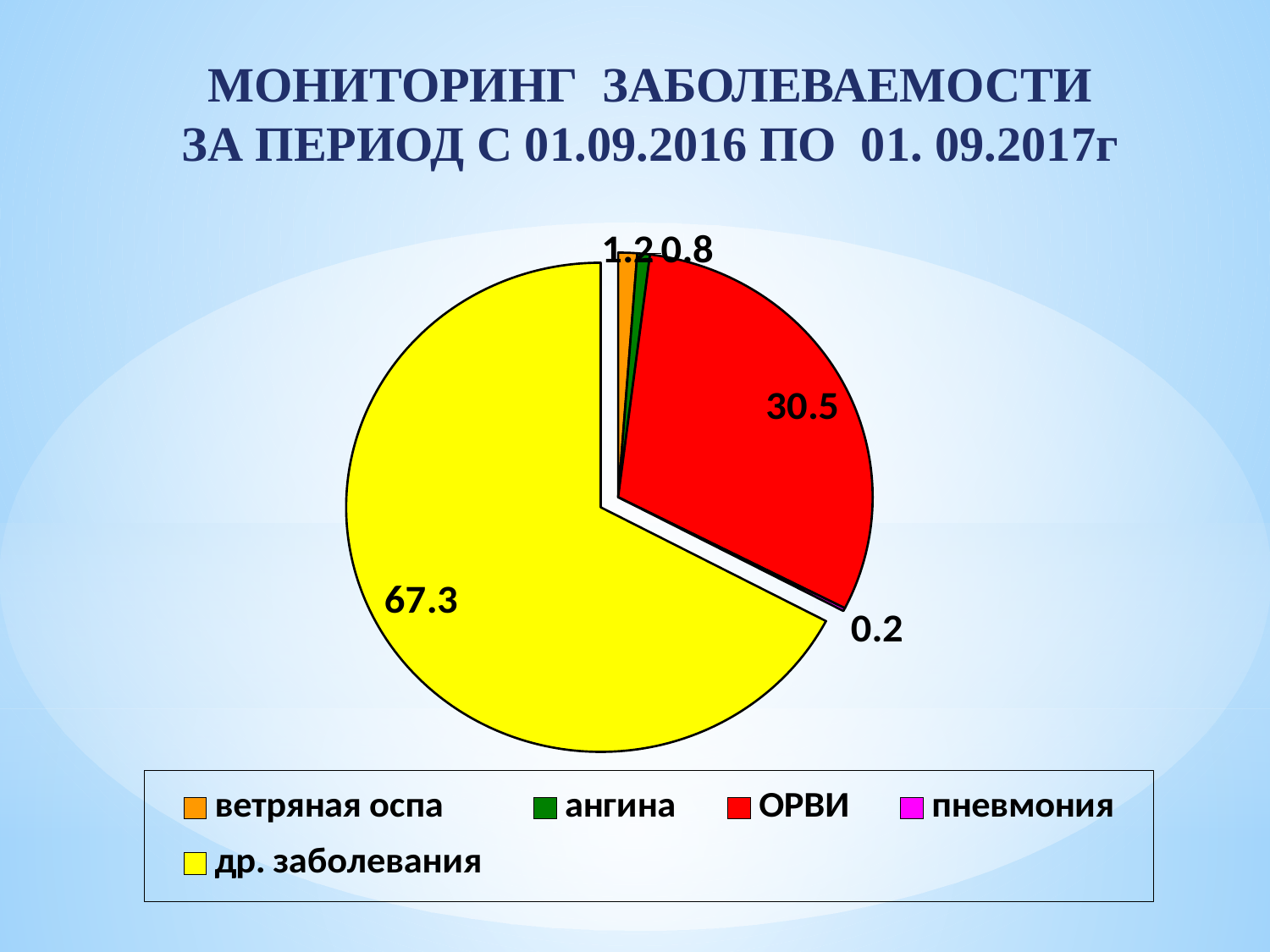
Which category is shown in yellow? др. заболевания Which category has the largest slice of the pie? др. заболевания Which category has the smallest slice of the pie? пневмония How many categories does the legend list? 5 What is the value for ангина? 0.8 What colour is the slice for ОРВИ? red What is the difference between the values for др. заболевания and ОРВИ? 36.8 What is the value for ОРВИ? 30.5 What kind of chart is shown on the slide? pie chart What is the value for пневмония? 0.2 Which is larger, the value for ОРВИ or the value for ангина? ОРВИ What is the value for др. заболевания? 67.3